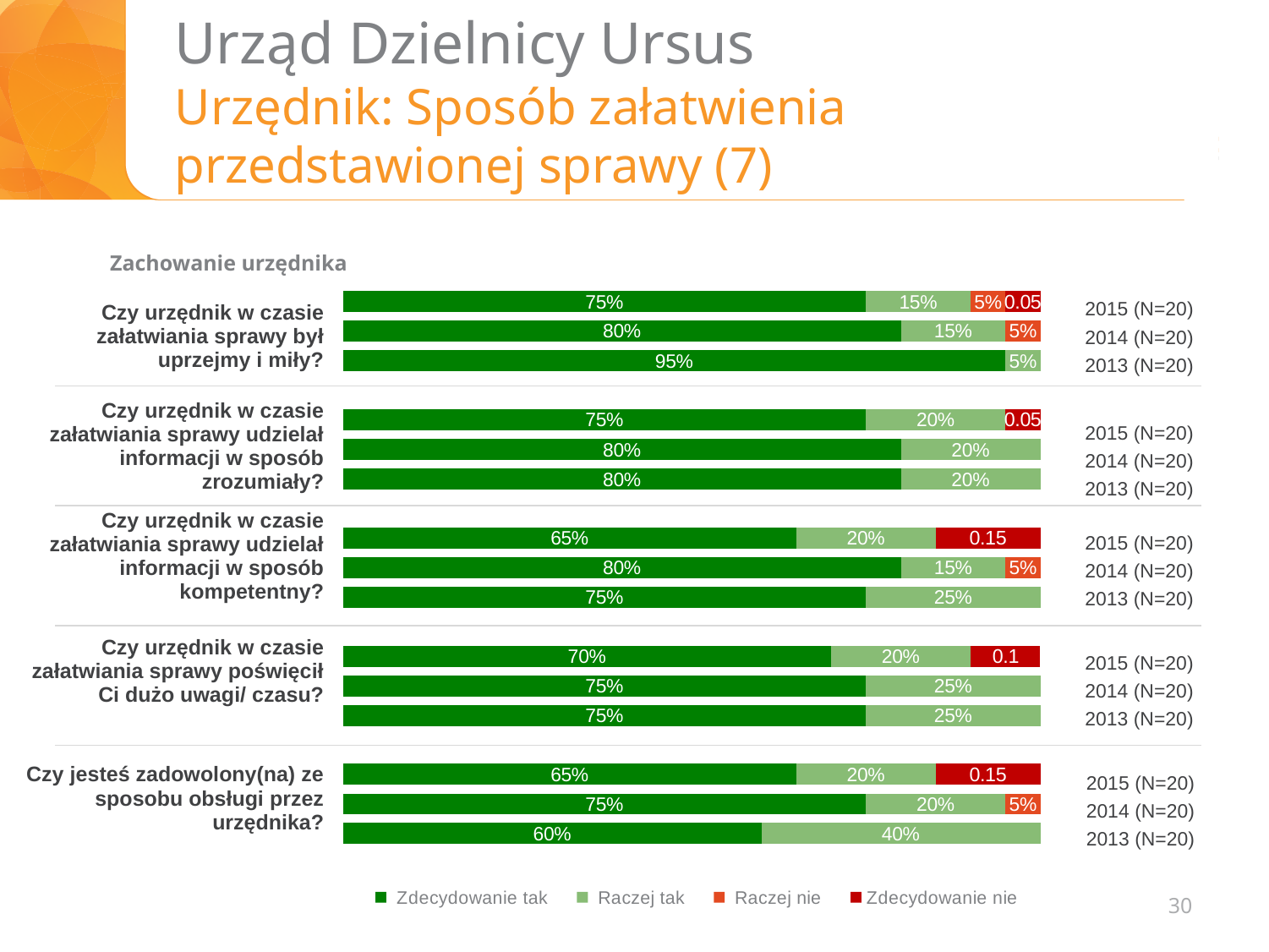
In the chart for "Czy urzędnik w czasie załatwiania sprawy udzielał informacji w sposób kompetentny?", what is the "Zdecydowanie nie" value for 2015 (N=20)? 0.15 In the chart for "Czy jesteś zadowolony(na) ze sposobu obsługi przez urzędnika?", which year has the highest "Zdecydowanie tak" value? 2014 (N=20) How many bars (years) are shown in the chart for "Czy urzędnik w czasie załatwiania sprawy udzielał informacji w sposób zrozumiały?"? 3 In the chart for "Czy urzędnik w czasie załatwiania sprawy poświęcił Ci dużo uwagi/ czasu?", what is the "Zdecydowanie tak" value for 2015 (N=20)? 70% How many series does the legend at the bottom of the slide list? 4 In the chart for "Czy urzędnik w czasie załatwiania sprawy był uprzejmy i miły?", what is the "Zdecydowanie tak" value for 2013 (N=20)? 95% In the chart for "Czy jesteś zadowolony(na) ze sposobu obsługi przez urzędnika?", what is the "Raczej tak" value for 2013 (N=20)? 40% In the chart for "Czy urzędnik w czasie załatwiania sprawy był uprzejmy i miły?", what is the "Raczej tak" value for 2015 (N=20)? 15% In the chart for "Czy jesteś zadowolony(na) ze sposobu obsługi przez urzędnika?", is the "Zdecydowanie tak" value larger for 2015 or for 2013? 2015 What kind of chart is used on this slide? Stacked bar chart In the chart for "Czy urzędnik w czasie załatwiania sprawy był uprzejmy i miły?", which year has the lowest "Zdecydowanie tak" value? 2015 (N=20) In the chart for "Czy urzędnik w czasie załatwiania sprawy udzielał informacji w sposób kompetentny?", what is the difference between the "Zdecydowanie tak" values for 2014 and 2015? 15%